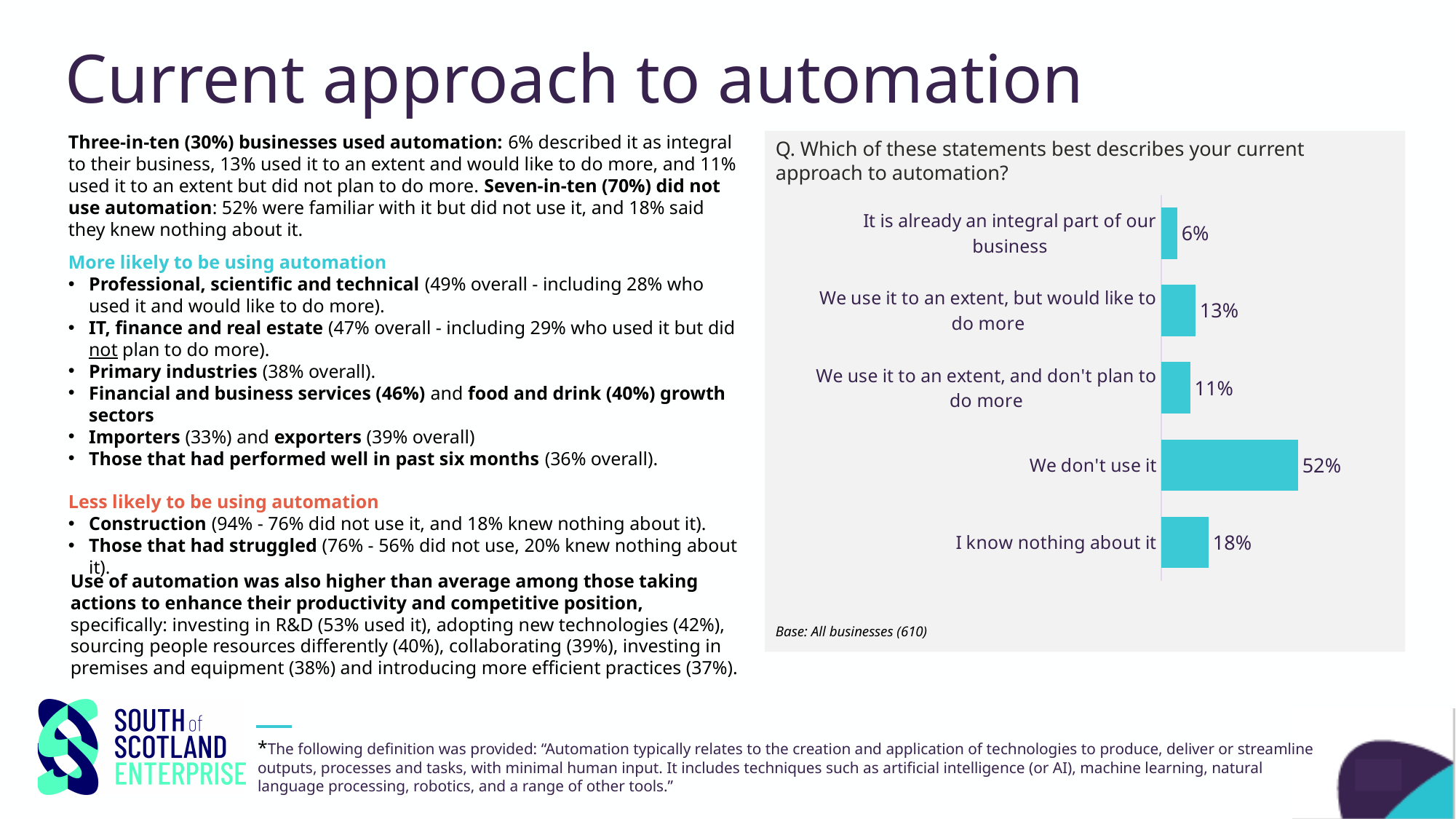
What percentage of businesses use automation to an extent but would like to do more? 13% What percentage of businesses said 'I know nothing about it'? 18% How many statements (categories) are shown in the chart? 5 What is the difference in percentage points between 'We don't use it' and 'I know nothing about it'? 34 What type of chart is used to show the responses? Bar chart What percentage of businesses said 'We don't use it'? 52% Which statement has the lowest percentage of businesses? It is already an integral part of our business What is the difference in percentage points between 'We use it to an extent, but would like to do more' and 'It is already an integral part of our business'? 7 What percentage of businesses said automation is already an integral part of their business? 6% What is the base (number of respondents) stated for the chart? All businesses (610) Which statement has the highest percentage of businesses? We don't use it Which is larger: the share that use it to an extent but would like to do more, or the share that use it to an extent and don't plan to do more? We use it to an extent, but would like to do more